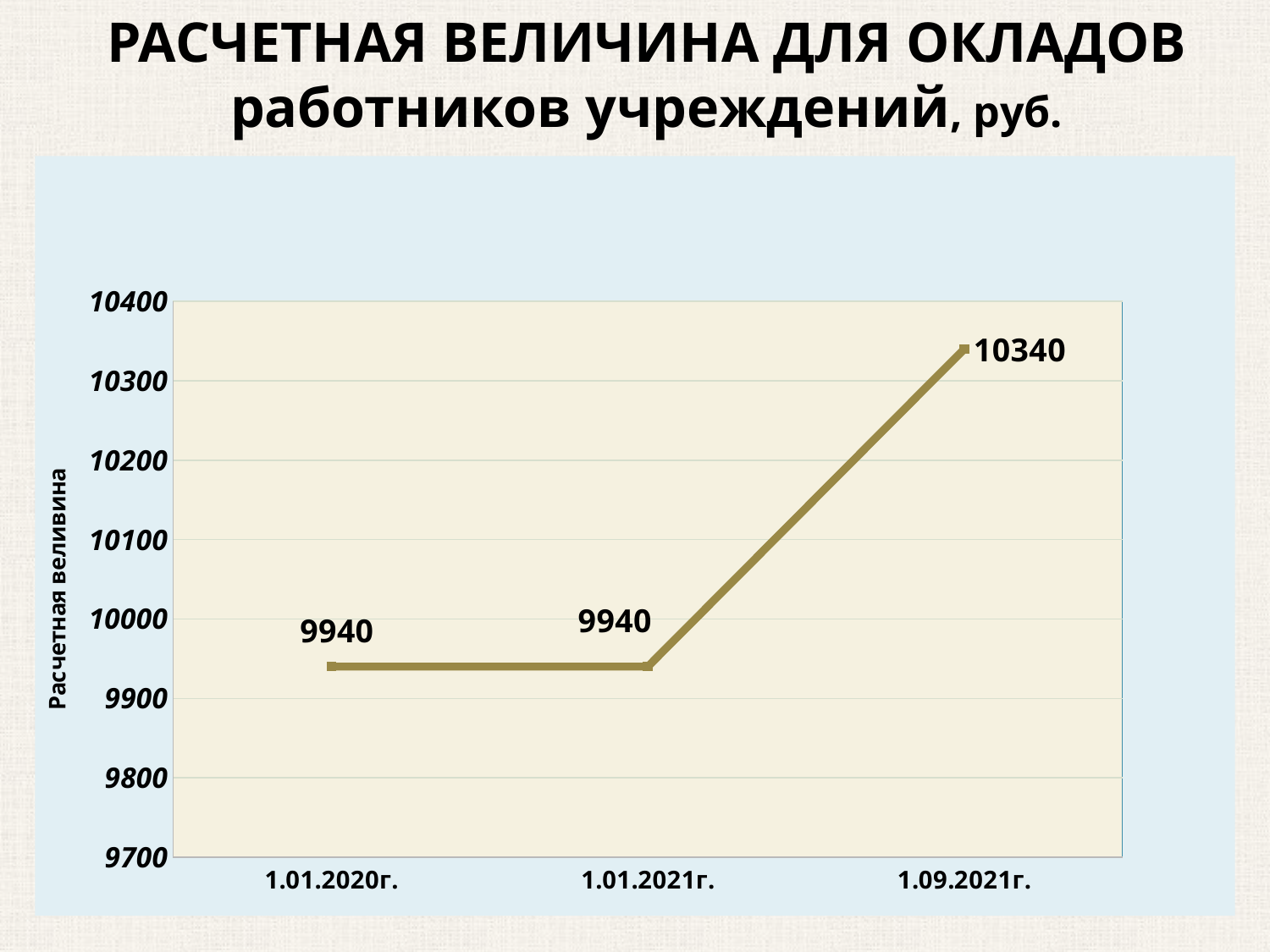
What is the value for 1.01.2021г.? 9940 Is the value for 1.01.2020г. greater or less than 10000? less Which is larger, the value for 1.09.2021г. or the value for 1.01.2020г.? 1.09.2021г. What is the value for 1.01.2020г.? 9940 Is the value for 1.09.2021г. greater or less than 10300? greater What is the value for 1.09.2021г.? 10340 Do the values rise or fall from 1.01.2021г. to 1.09.2021г.? rise What is the label of the vertical axis? Расчетная веливина Which date has the highest value? 1.09.2021г. What is the difference between the values for 1.09.2021г. and 1.01.2021г.? 400 How many data points are plotted on the chart? 3 What type of chart is shown on the slide? line chart